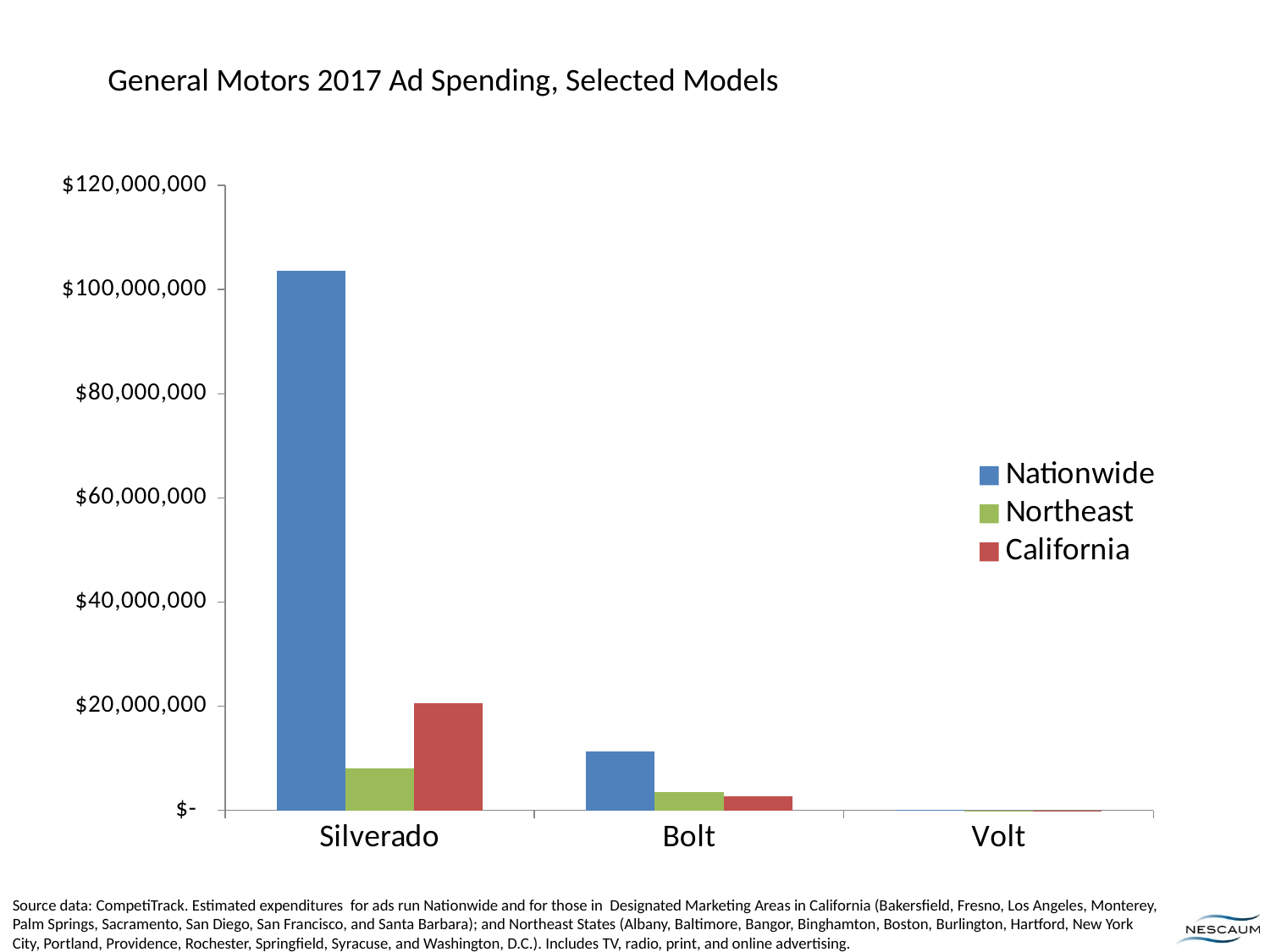
How many models (categories) are shown on the x axis? 3 How many series does the legend list? 3 Is the Nationwide value for Bolt greater or less than $20,000,000? less Is the California value for Silverado greater or less than $40,000,000? less What kind of chart is shown on the slide? Bar chart Which model has the highest Nationwide ad spending? Silverado What is the title of the chart? General Motors 2017 Ad Spending, Selected Models Is the Nationwide value for Silverado greater or less than $80,000,000? greater Which model has the lowest Nationwide ad spending? Volt For Silverado, which is larger: the Northeast value or the California value? California Do the Nationwide values rise or fall moving from Silverado to Volt along the x axis? fall Which is larger: the Nationwide value for Bolt or the California value for Silverado? California value for Silverado